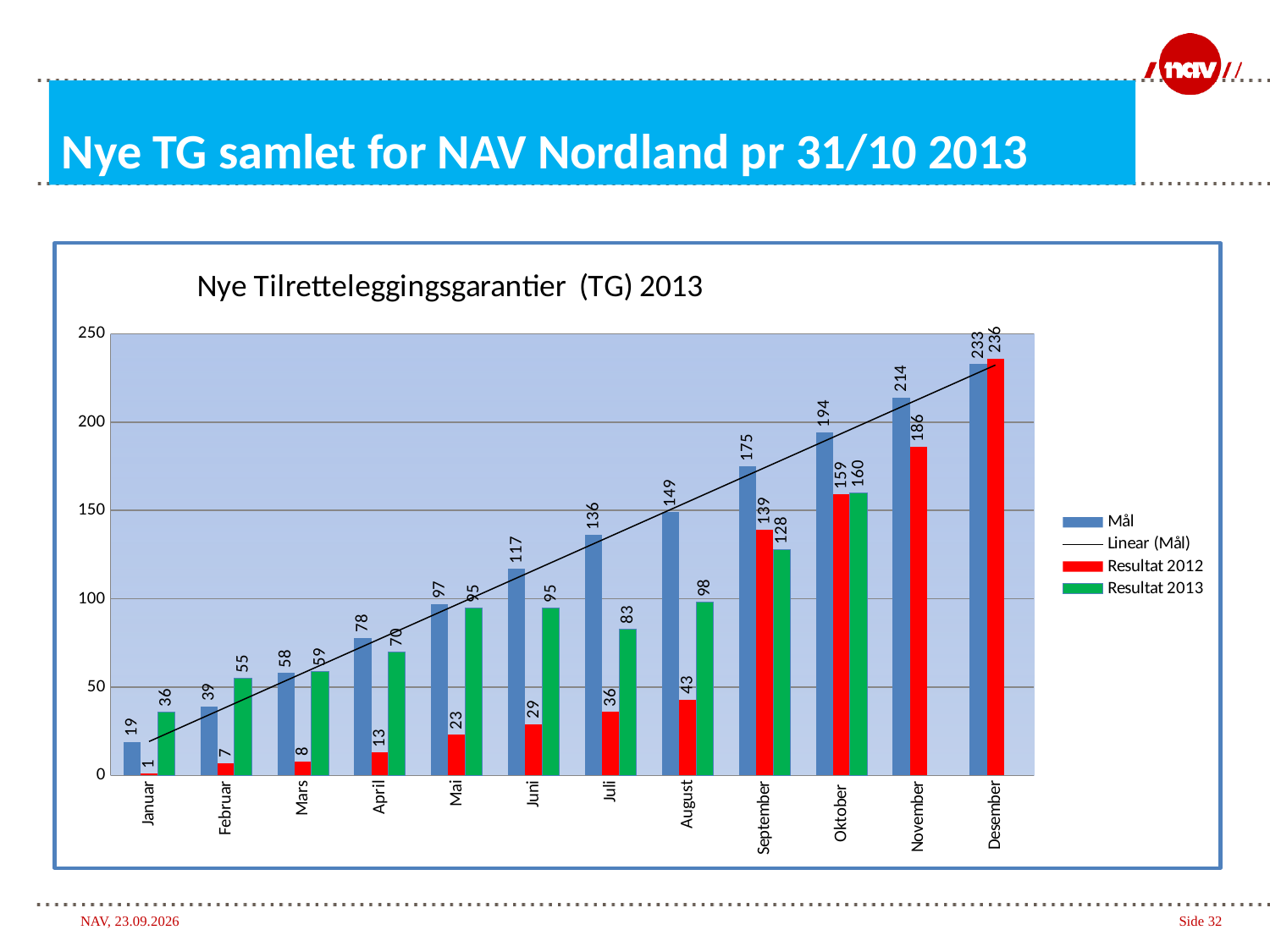
What is the Resultat 2012 value for Januar? 1 Which is larger for Juli: the Resultat 2012 value or the Resultat 2013 value? Resultat 2013 How many months are shown on the x axis? 12 What kind of chart is this? Bar chart What is the Mål value for September? 175 Which month has the lowest Mål value? Januar What is the difference between the Mål value and the Resultat 2013 value for August? 51 Do the Mål values rise or fall from Januar to Desember? Rise Which month has the highest Resultat 2012 value? Desember What is the Resultat 2013 value for Oktober? 160 How many entries does the legend list? 4 What is the title of the chart? Nye Tilretteleggingsgarantier (TG) 2013